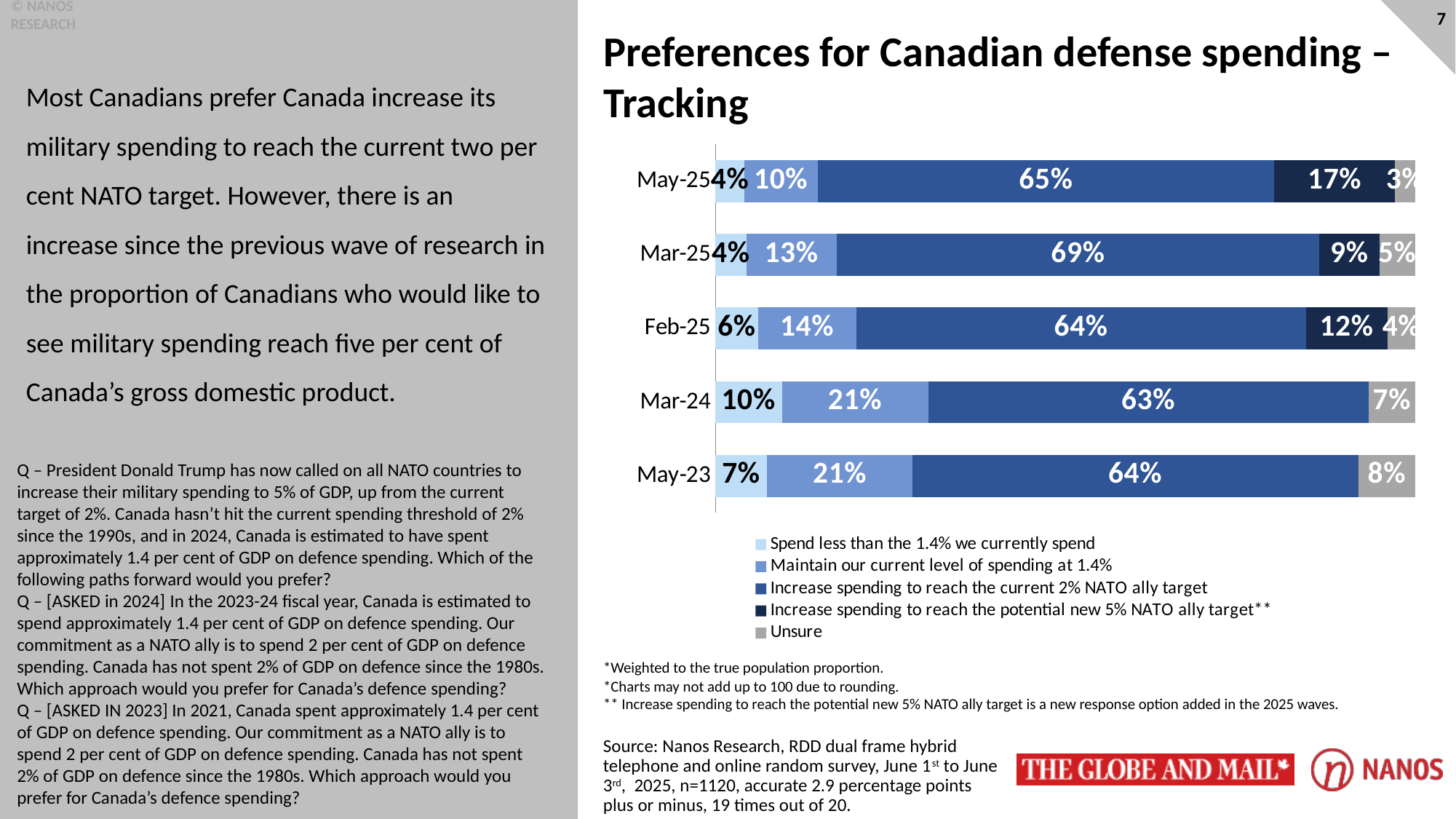
In which wave was the share preferring to spend less than the 1.4% currently spent highest? Mar-24 What percentage of respondents in May-25 preferred to increase spending to reach the current 2% NATO ally target? 65% What is the difference between the May-25 and Mar-25 shares preferring to increase spending to reach the potential new 5% NATO ally target? 8 percentage points What is the title of the chart? Preferences for Canadian defense spending – Tracking What percentage of respondents in Mar-24 were unsure? 7% What percentage of respondents in Mar-25 preferred to increase spending to reach the potential new 5% NATO ally target? 9% What percentage of respondents in Feb-25 preferred to maintain the current level of spending at 1.4%? 14% How many series does the legend list? 5 What kind of chart is shown on the slide? Stacked bar chart In which wave was the share preferring to increase spending to reach the current 2% NATO target highest? Mar-25 How many survey waves (categories) are shown on the chart? 5 Which is larger: the share preferring to maintain current spending in May-23 or in May-25? May-23